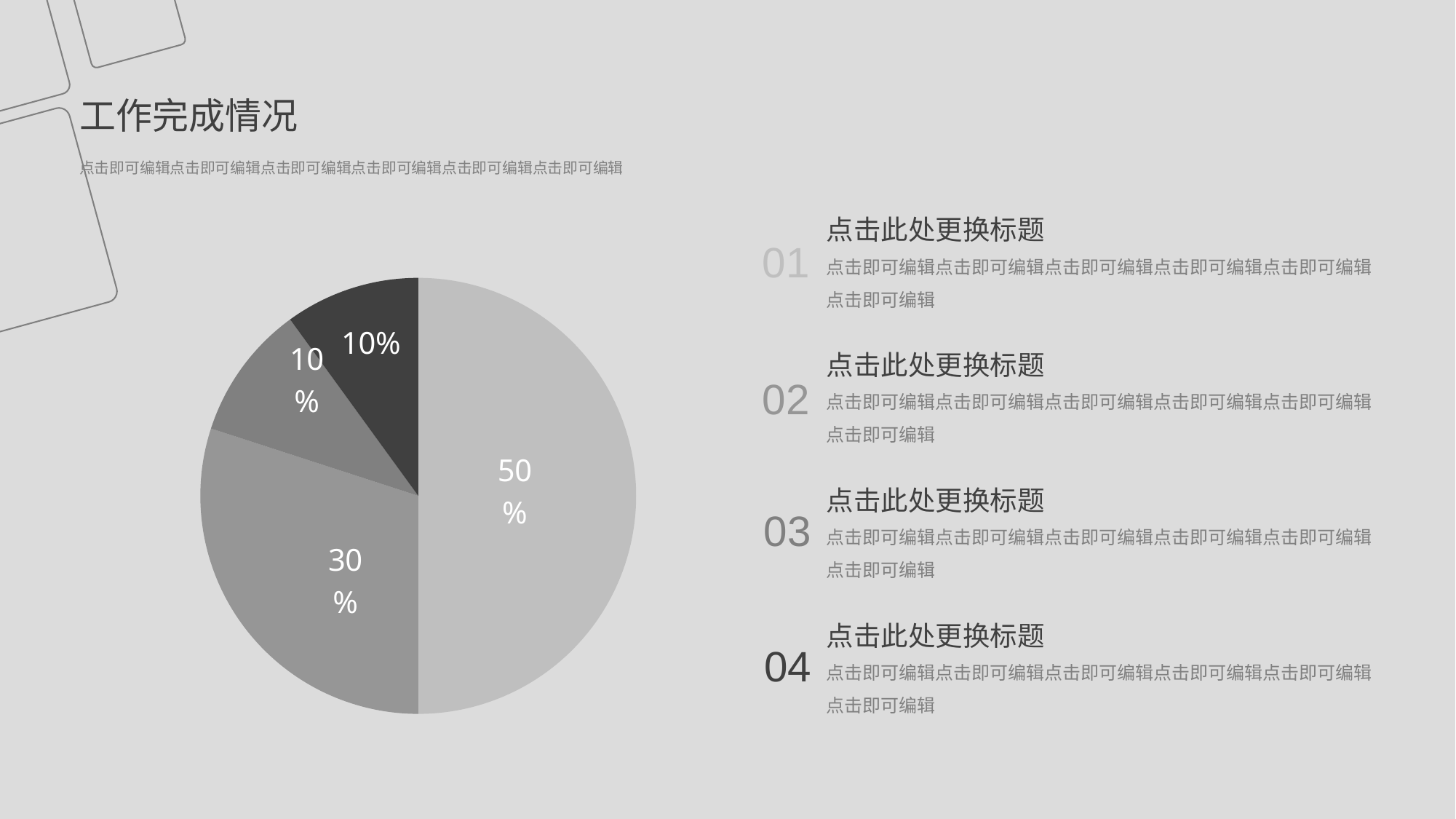
How many slices does the pie chart have? 4 What value is labelled on the lightest grey slice on the right half of the pie chart? 50% What share of the pie does the largest slice represent? 50% What is the title of the slide containing the pie chart? 工作完成情况 What kind of chart is shown on the slide? pie chart What is the value of the largest slice of the pie chart? 50% Which slice is larger, the lightest grey slice or the darkest slice? the lightest grey slice What is the difference between the largest slice (50%) and the 30% slice? 20 percentage points What value is labelled on the medium grey slice in the lower-left of the pie chart? 30% What value is labelled on the darkest slice of the pie chart? 10% What is the value of the smallest slice of the pie chart? 10% How many slices of the pie chart are labelled 10%? 2